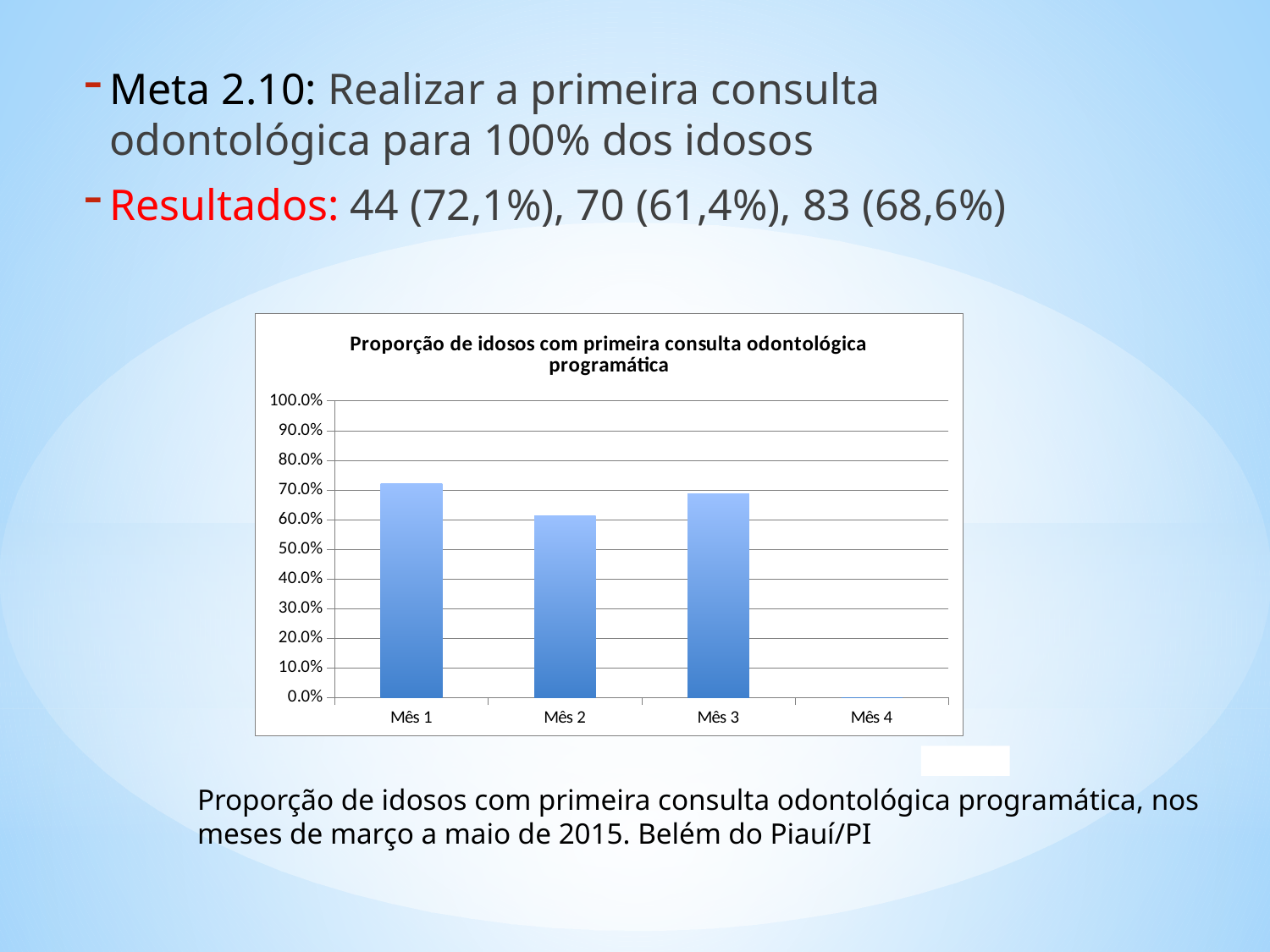
Does the value fall or rise from Mês 1 to Mês 2? fall What is the title of the chart? Proporção de idosos com primeira consulta odontológica programática What kind of chart is shown on the slide? bar chart Which month has the highest bar in the chart? Mês 1 How many categories are labelled on the x axis of the chart? 4 Is the value for Mês 3 greater or less than 60.0%? greater Is the value for Mês 1 greater or less than 70.0%? greater Is the value for Mês 2 greater or less than 50.0%? greater Among Mês 1, Mês 2 and Mês 3, which has the lowest value? Mês 2 Which is larger, the value for Mês 3 or the value for Mês 2? Mês 3 Which is larger, the value for Mês 1 or the value for Mês 2? Mês 1